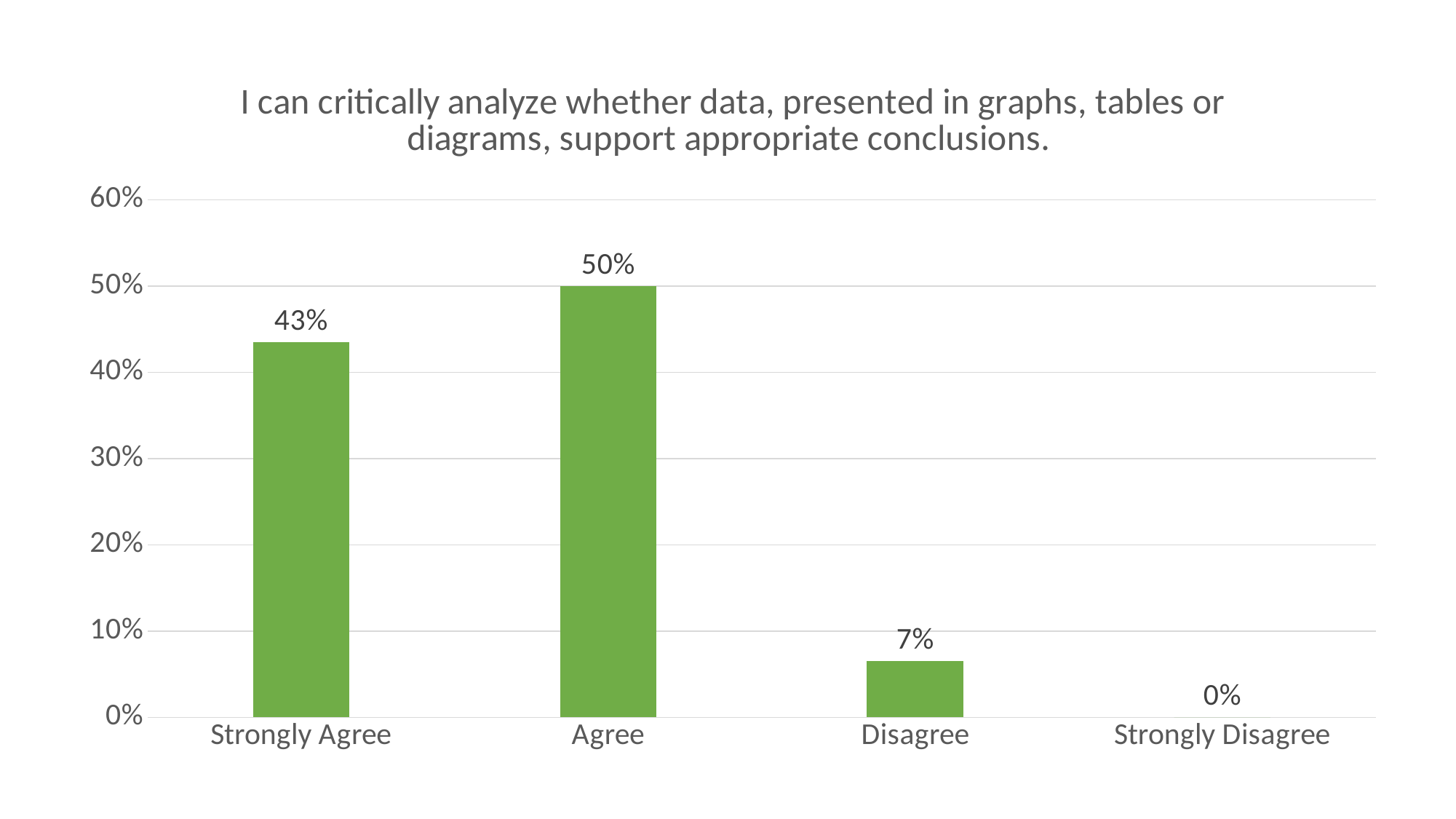
What is the value for Disagree? 7% What is the title of the chart? I can critically analyze whether data, presented in graphs, tables or diagrams, support appropriate conclusions. What is the difference between the values for Agree and Strongly Agree? 7% What is the value for Agree? 50% How many categories are shown on the x axis? 4 What kind of chart is shown on the slide? Bar chart Which is larger, the value for Strongly Agree or the value for Disagree? Strongly Agree What is the value for Strongly Agree? 43% Which category has the lowest value? Strongly Disagree What is the difference between the values for Strongly Agree and Disagree? 36% What is the value for Strongly Disagree? 0% Which category has the highest value? Agree